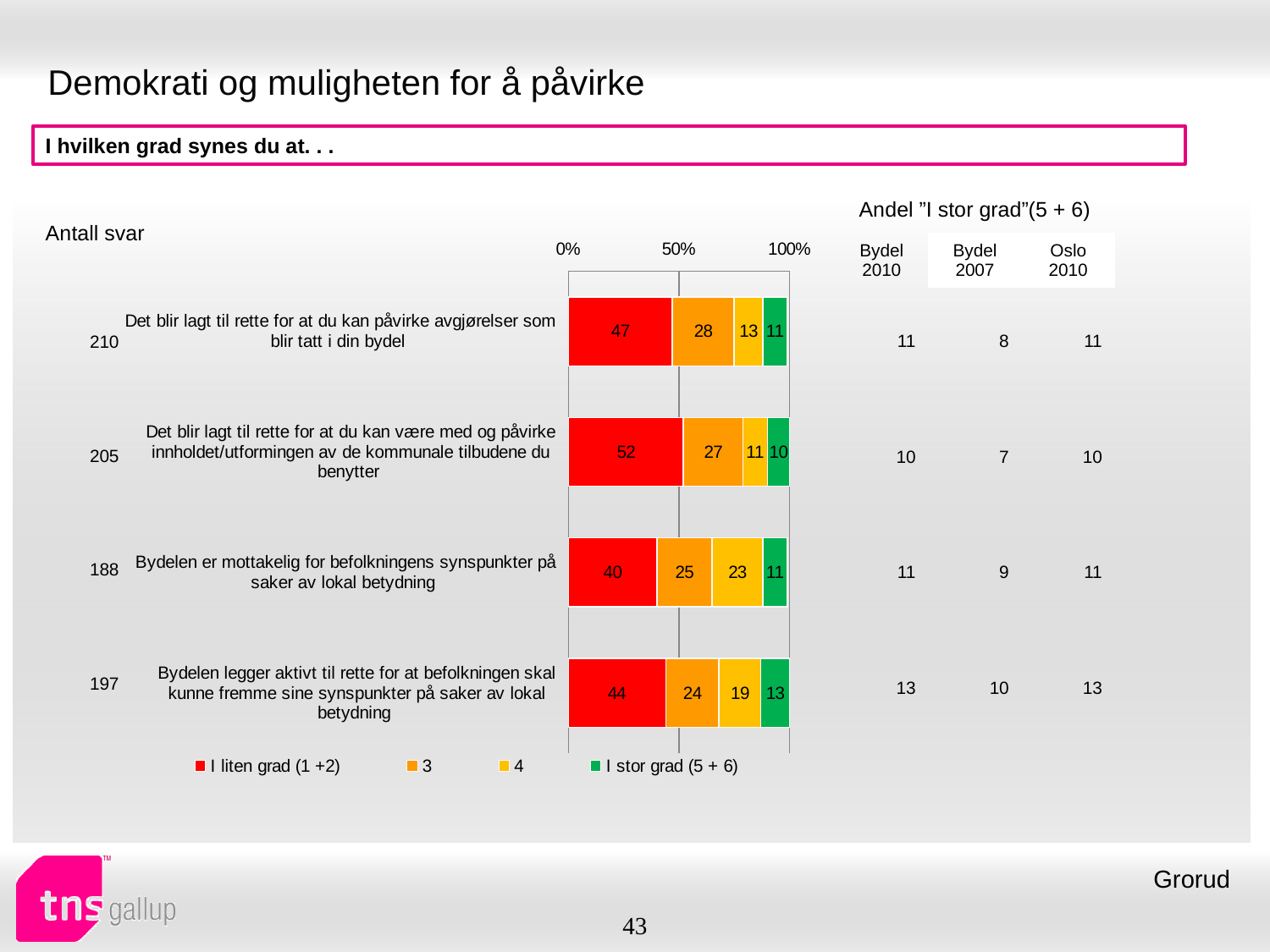
What is the difference between the 'I liten grad (1 +2)' values for 'Det blir lagt til rette for at du kan være med og påvirke innholdet/utformingen av de kommunale tilbudene du benytter' and 'Bydelen er mottakelig for befolkningens synspunkter på saker av lokal betydning'? 12 What is the total of the stacked bar for 'Det blir lagt til rette for at du kan være med og påvirke innholdet/utformingen av de kommunale tilbudene du benytter'? 100 What type of chart is shown on the slide? stacked bar chart How many series does the chart legend list? 4 What colour represents 'I stor grad (5 + 6)' in the chart? green Which statement has the lowest 'I liten grad (1 +2)' value? Bydelen er mottakelig for befolkningens synspunkter på saker av lokal betydning How many statements (categories) are plotted in the chart? 4 Which statement has the highest 'I liten grad (1 +2)' value? Det blir lagt til rette for at du kan være med og påvirke innholdet/utformingen av de kommunale tilbudene du benytter What is the value of 'I stor grad (5 + 6)' for 'Bydelen legger aktivt til rette for at befolkningen skal kunne fremme sine synspunkter på saker av lokal betydning'? 13 What is the value of series '4' for 'Bydelen er mottakelig for befolkningens synspunkter på saker av lokal betydning'? 23 Which is larger: the series '3' value for 'Det blir lagt til rette for at du kan påvirke avgjørelser som blir tatt i din bydel' or for 'Bydelen legger aktivt til rette for at befolkningen skal kunne fremme sine synspunkter på saker av lokal betydning'? Det blir lagt til rette for at du kan påvirke avgjørelser som blir tatt i din bydel What is the value of 'I liten grad (1 +2)' for 'Det blir lagt til rette for at du kan påvirke avgjørelser som blir tatt i din bydel'? 47